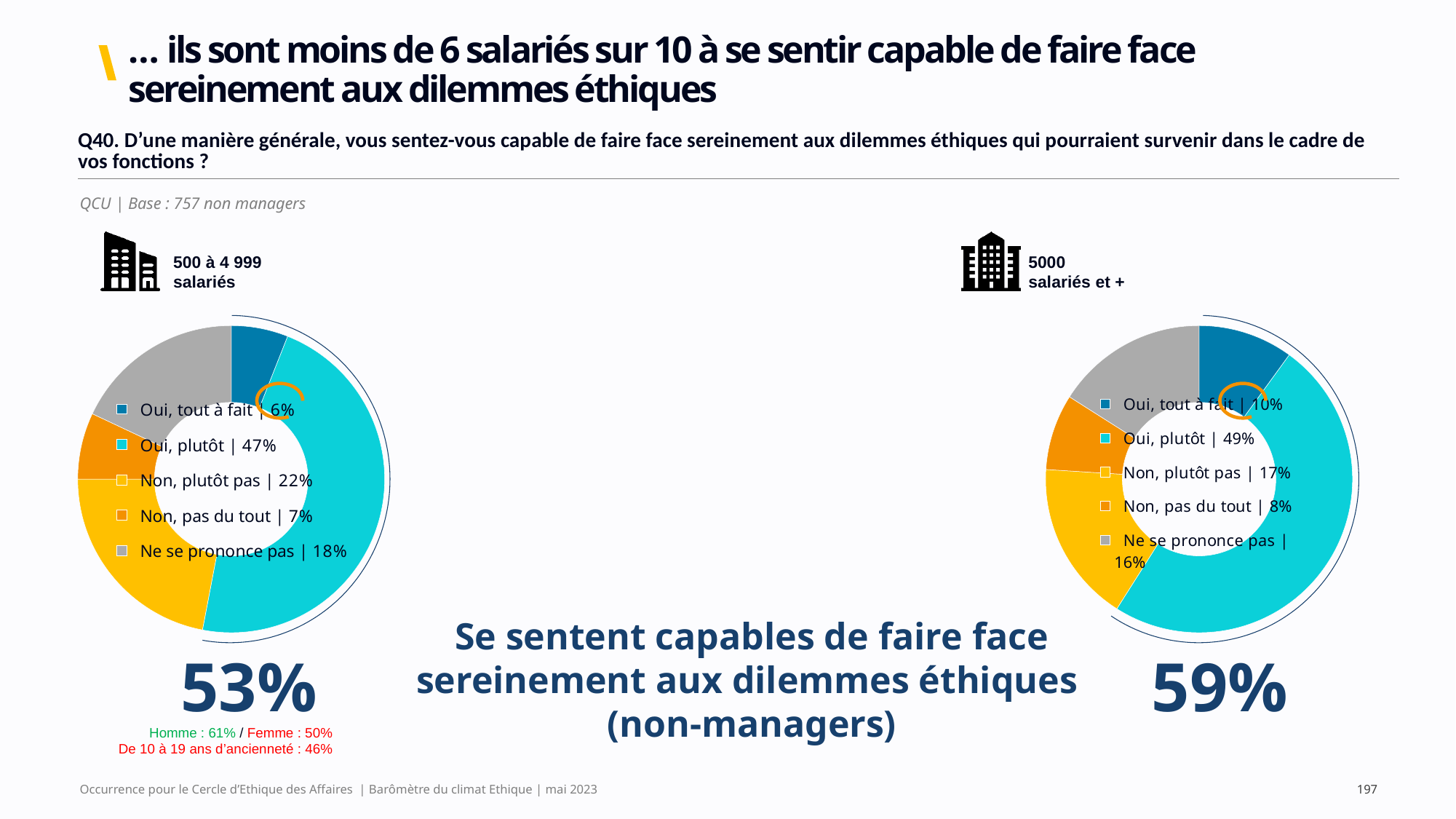
In the chart for '500 à 4 999 salariés', which response category has the largest share? Oui, plutôt Is the 'Ne se prononce pas' share larger in the '500 à 4 999 salariés' chart or in the '5000 salariés et +' chart? 500 à 4 999 salariés In the chart for '5000 salariés et +', which response category has the smallest share? Non, pas du tout How many response categories does the chart for '500 à 4 999 salariés' show? 5 In the chart for '5000 salariés et +', what percentage answered 'Non, plutôt pas'? 17% In the chart for '500 à 4 999 salariés', what percentage answered 'Oui, plutôt'? 47% What large percentage is printed below the chart for '5000 salariés et +'? 59% In the chart for '500 à 4 999 salariés', what is the combined share of 'Oui, tout à fait' and 'Oui, plutôt'? 53% In the chart for '500 à 4 999 salariés', what colour represents 'Ne se prononce pas'? Grey What type of chart is used for the '5000 salariés et +' data? Donut (pie) chart What is the difference between the 'Oui, tout à fait' share in the '5000 salariés et +' chart and in the '500 à 4 999 salariés' chart? 4 percentage points In the chart for '5000 salariés et +', what is the combined share of 'Non, plutôt pas' and 'Non, pas du tout'? 25%